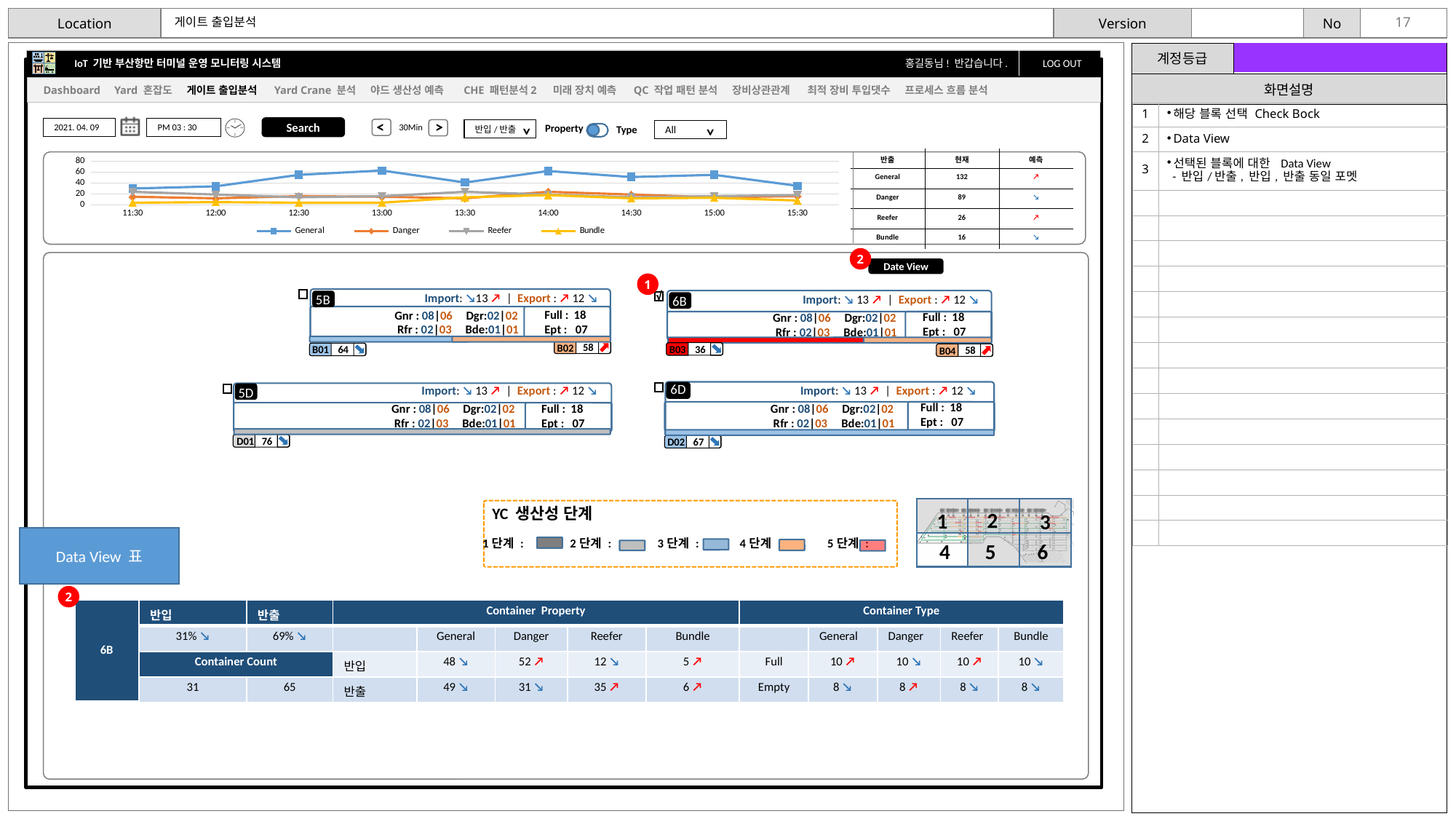
In the line chart, is the value for Bundle at 12:30 greater or less than 20? less In the line chart, which is larger at 14:00, General or Bundle? General What is the highest tick value shown on the y axis of the line chart? 80 In the line chart, is the value for General at 11:30 greater or less than 20? greater In the line chart, is the value for General at 13:00 greater or less than 40? greater What is the first time label on the x axis of the line chart? 11:30 In the line chart, does the General series rise or fall from 12:00 to 13:00? rise What kind of chart is shown at the top of the slide? line chart How many time points are plotted along the x axis of the line chart? 9 Which series in the line chart has the highest values across the time points? General How many series does the legend of the line chart list? 4